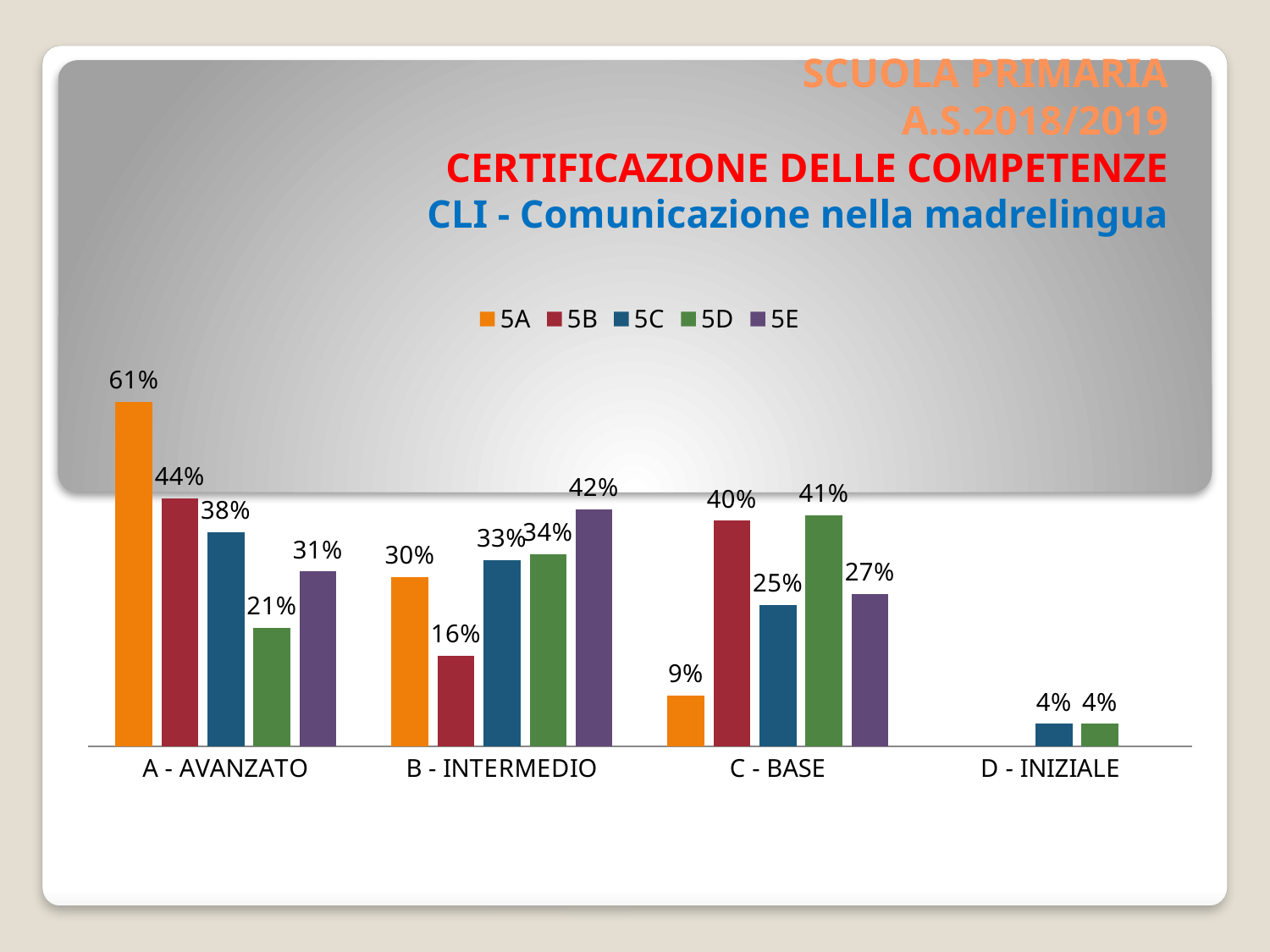
What is the value for 5C in the C - BASE category? 25% Which series has the highest value in the A - AVANZATO category? 5A How many series does the legend list? 5 Which series is shown in orange in the legend? 5A What kind of chart is shown on the slide? Bar chart What is the value for 5D in the D - INIZIALE category? 4% Which series has the lowest value in the C - BASE category? 5A Which is larger in the B - INTERMEDIO category, the value for 5A or the value for 5B? 5A What is the difference between the 5A and 5B values in the A - AVANZATO category? 17% What is the value for 5E in the B - INTERMEDIO category? 42% What is the value for 5A in the A - AVANZATO category? 61% How many categories are shown on the x axis? 4